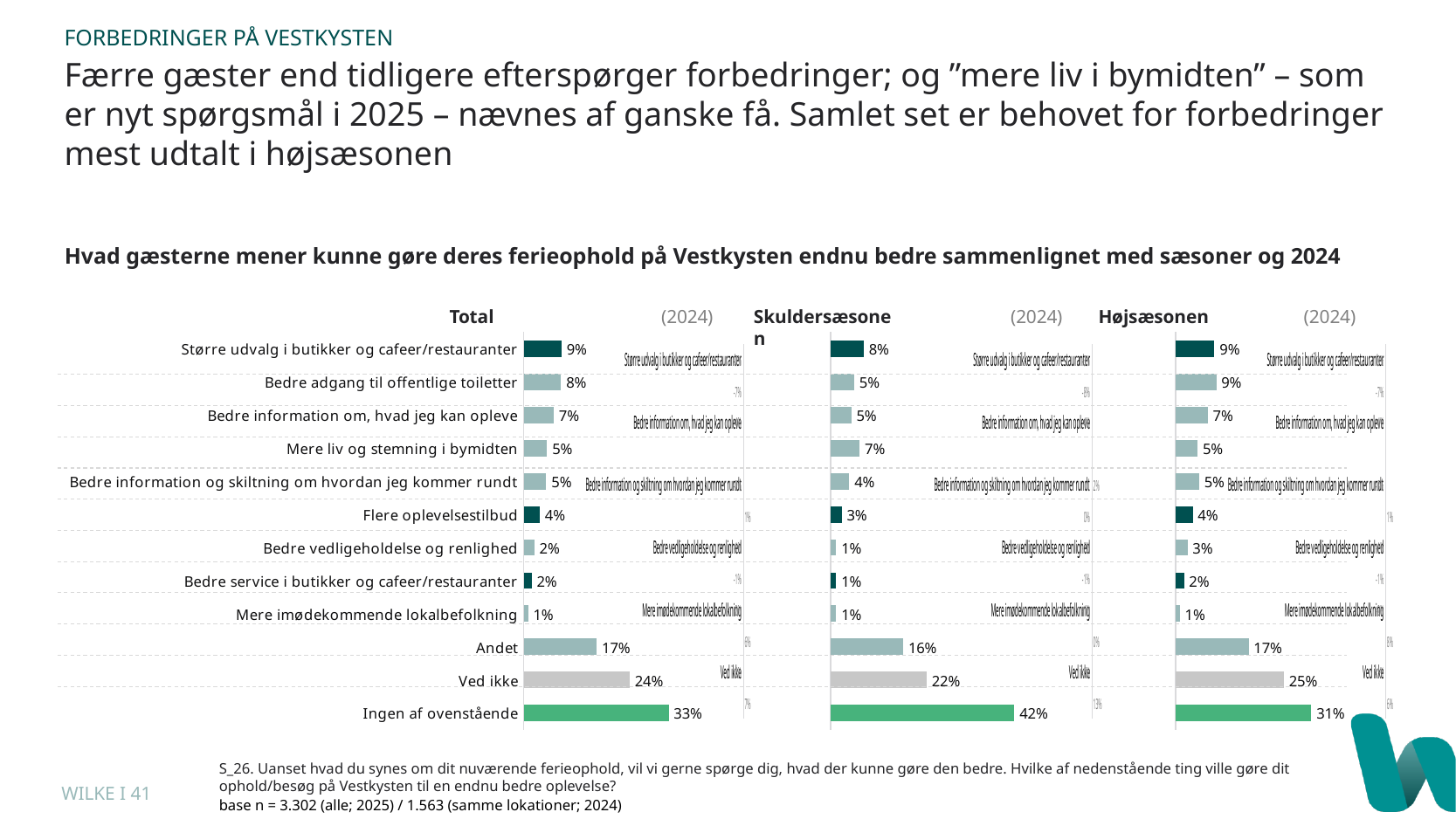
Which is larger: "Bedre adgang til offentlige toiletter" in the Skuldersæsonen chart or in the Højsæsonen chart? Højsæsonen How many categories are listed in the Total chart? 12 In the Total chart, which category has the lowest value? Mere imødekommende lokalbefolkning In the Højsæsonen chart, what percentage is shown for "Ved ikke"? 25% In the Total chart, what percentage is shown for "Ingen af ovenstående"? 33% In the Skuldersæsonen chart, what percentage is shown for "Mere liv og stemning i bymidten"? 7% What is the difference between "Ingen af ovenstående" in the Skuldersæsonen chart and in the Højsæsonen chart? 11 percentage points In the Skuldersæsonen chart, what percentage is shown for "Ingen af ovenstående"? 42% In the Total chart, what is the difference between "Ved ikke" and "Andet"? 7 percentage points In the Total chart, what percentage is shown for "Større udvalg i butikker og cafeer/restauranter"? 9% What type of chart is used to show the Total results? Bar chart In the Højsæsonen chart, which category has the highest value? Ingen af ovenstående